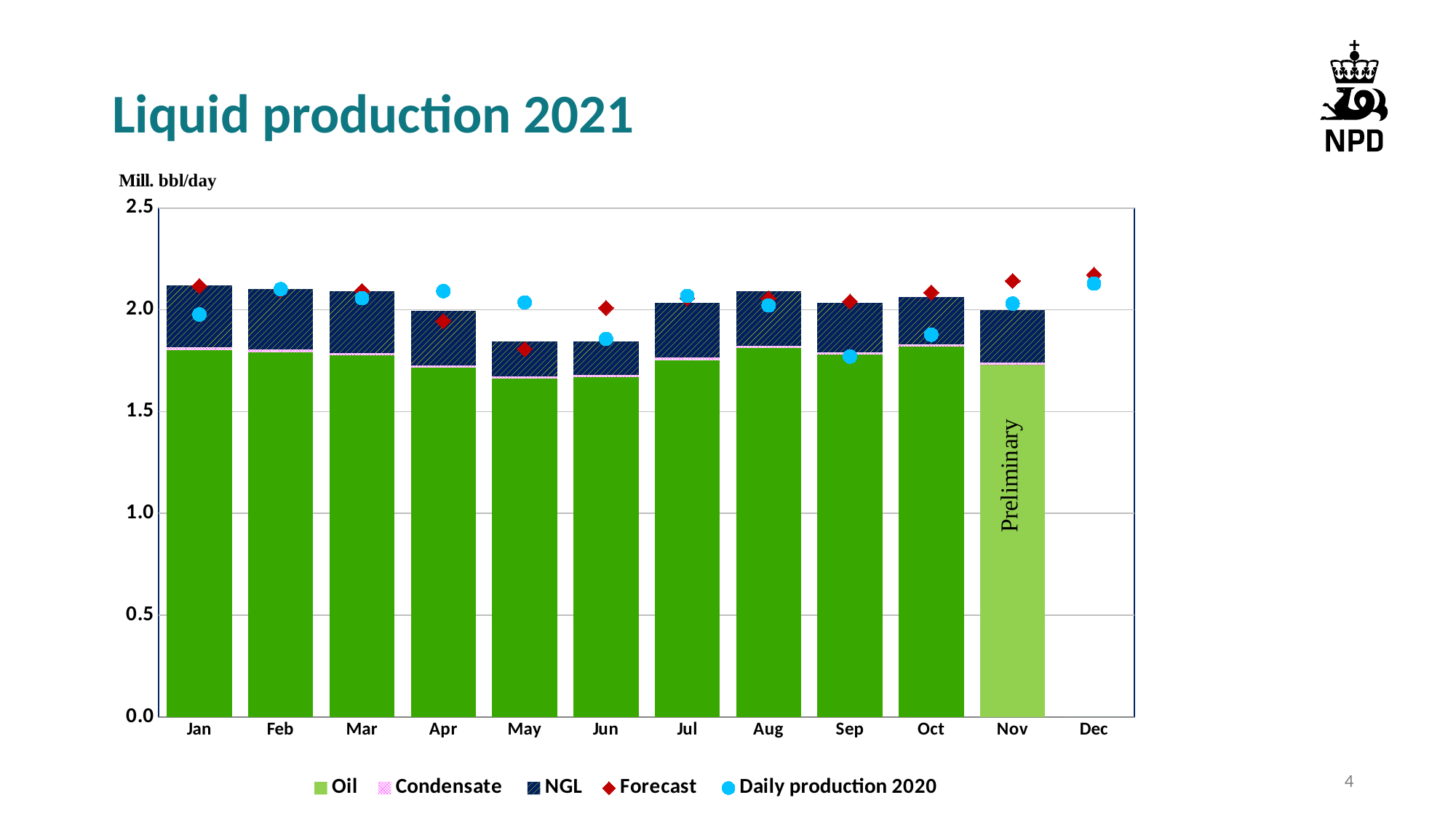
Is the Oil value for Jan greater or less than 1.5? greater Which month has no bar plotted, only markers? Dec What kind of chart is shown on the slide? Stacked bar chart with markers Which month's bar is labelled "Preliminary"? Nov Do the total stacked bars rise or fall from Jan to May? fall How many months are shown on the x axis? 12 Is the total stacked bar for Jan greater or less than 2.0? greater How many series does the legend list? 5 What unit is shown on the y axis? Mill. bbl/day Is the total stacked bar for May greater or less than 2.0? less Which has the larger total stacked bar, Jan or May? Jan